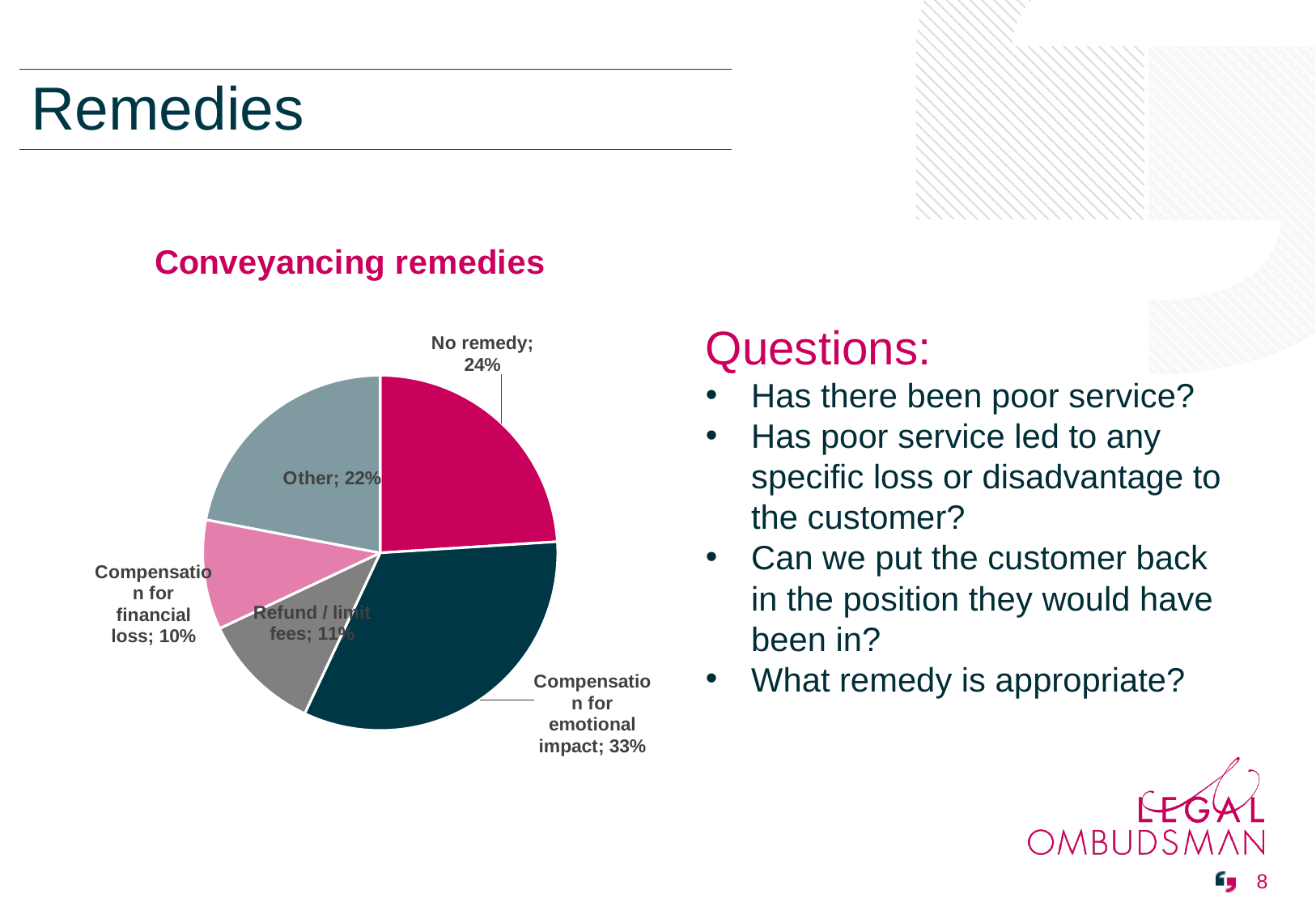
Which remedy has the largest share of the pie? Compensation for emotional impact What is the difference between the shares for 'Compensation for emotional impact' and 'No remedy'? 9% What share of the pie is 'Other'? 22% What share of the pie is 'Refund / limit fees'? 11% What share of the pie is 'No remedy'? 24% What share of the pie is 'Compensation for financial loss'? 10% What share of the pie is 'Compensation for emotional impact'? 33% Which is larger, the share for 'Other' or the share for 'Refund / limit fees'? Other Which remedy has the smallest share of the pie? Compensation for financial loss What kind of chart is shown on the slide? Pie chart How many slices does the pie chart have? 5 What is the title of the pie chart? Conveyancing remedies